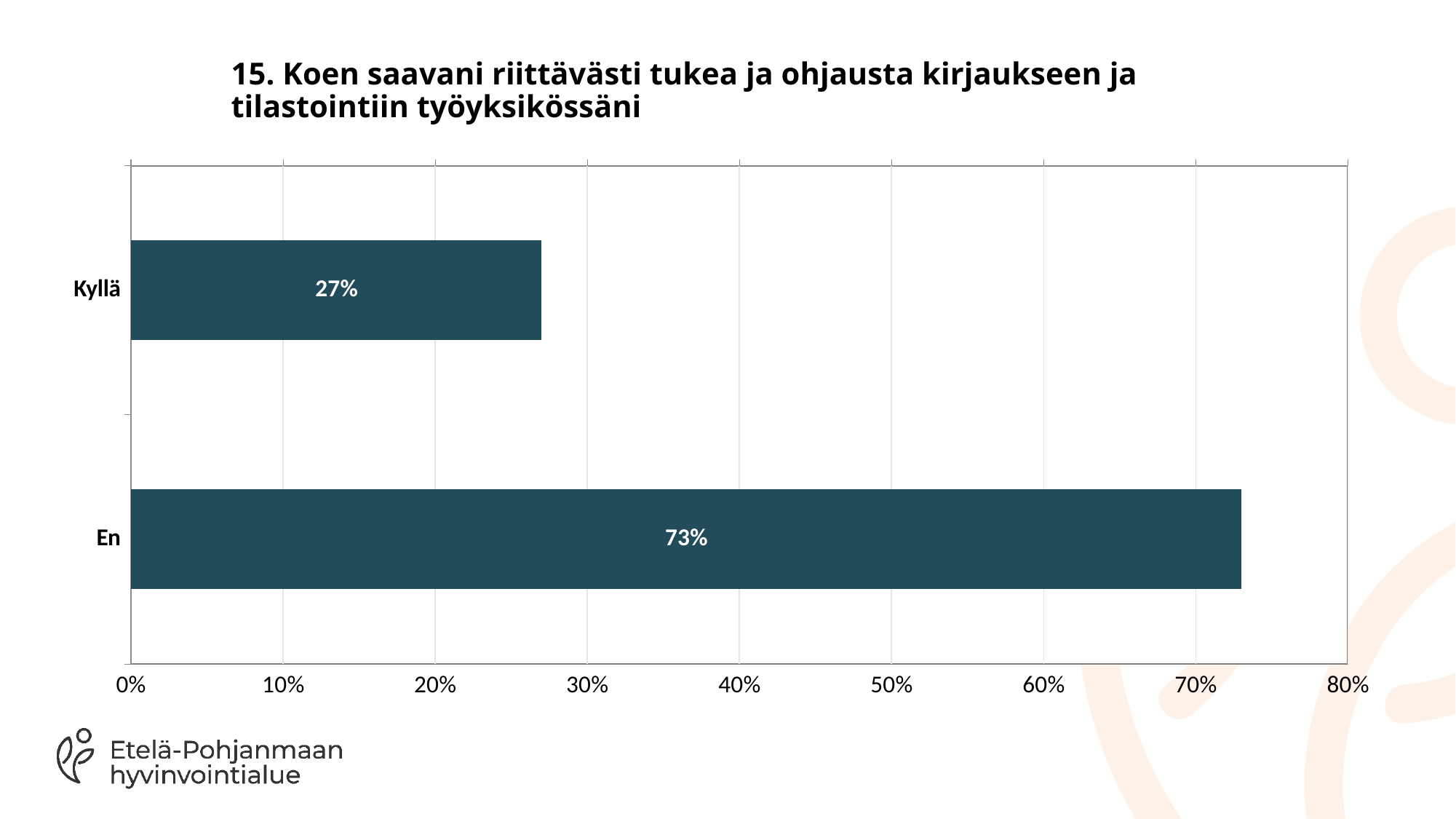
What is the difference between the values for En and Kyllä? 46% How many categories are shown in the chart? 2 Which is larger, the value for Kyllä or the value for En? En Which category has the highest value? En What is the value for Kyllä? 27% What kind of chart is shown on the slide? bar chart What is the highest value shown on the x axis? 80% Which category has the lowest value? Kyllä Is the value for Kyllä greater or less than 30%? less Is the value for En greater or less than 50%? greater What is the title of the chart? 15. Koen saavani riittävästi tukea ja ohjausta kirjaukseen ja tilastointiin työyksikössäni What is the value for En? 73%